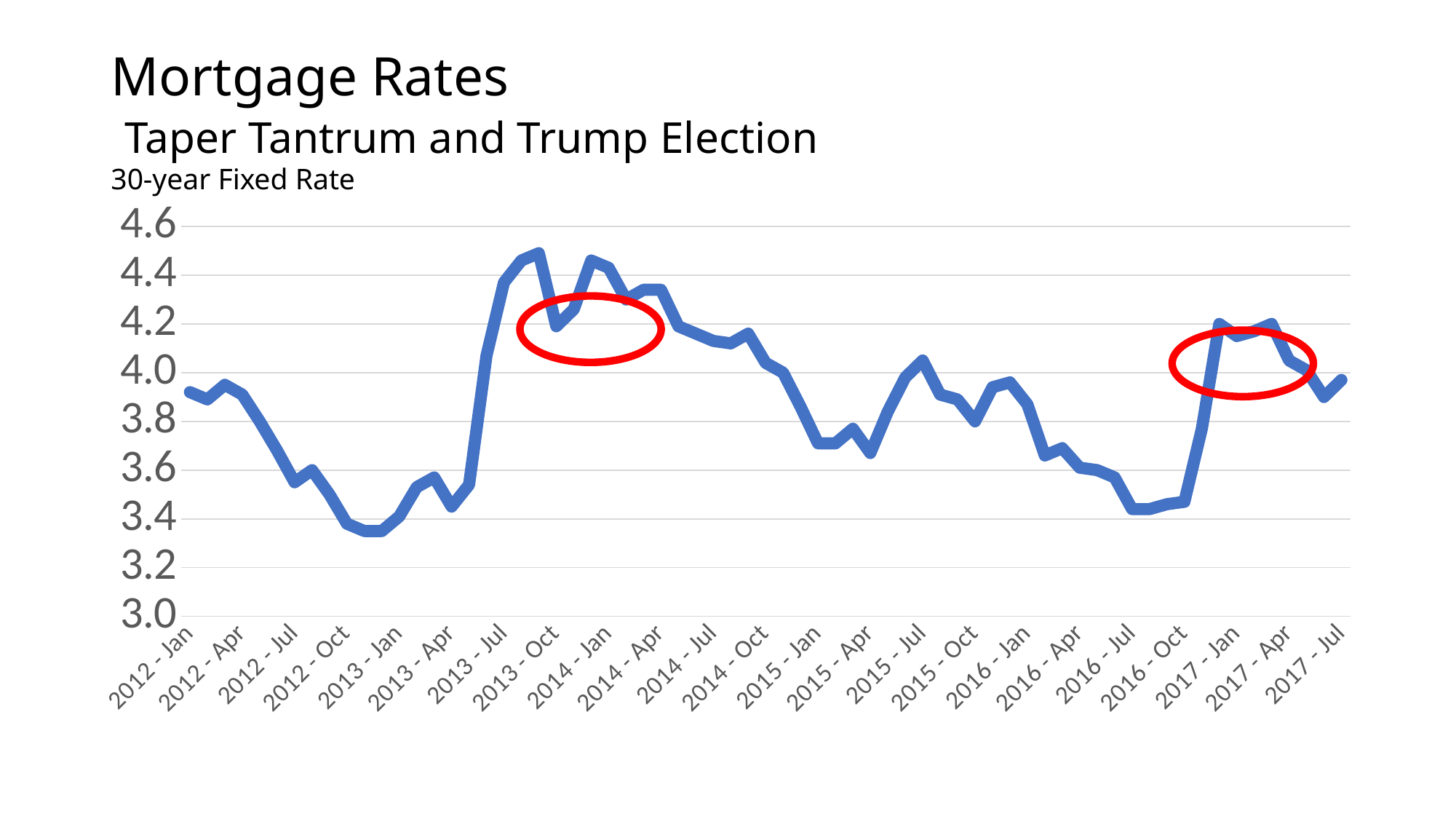
How many labels are shown on the x axis of the chart? 23 Is the value for 2016 - Jul greater or less than 3.6? less What kind of chart is shown on the slide? line chart Is the value for 2013 - Jul greater or less than 4.2? greater Is the value for 2012 - Oct greater or less than 3.6? less Does the 30-year fixed rate rise or fall between 2012 - Jan and 2012 - Oct? fall How many red circles are drawn on the chart? 2 What is the title of the chart on the slide? Mortgage Rates Does the 30-year fixed rate rise or fall between 2016 - Jul and 2017 - Jan? rise Which is larger, the value for 2014 - Jul or the value for 2016 - Jul? 2014 - Jul